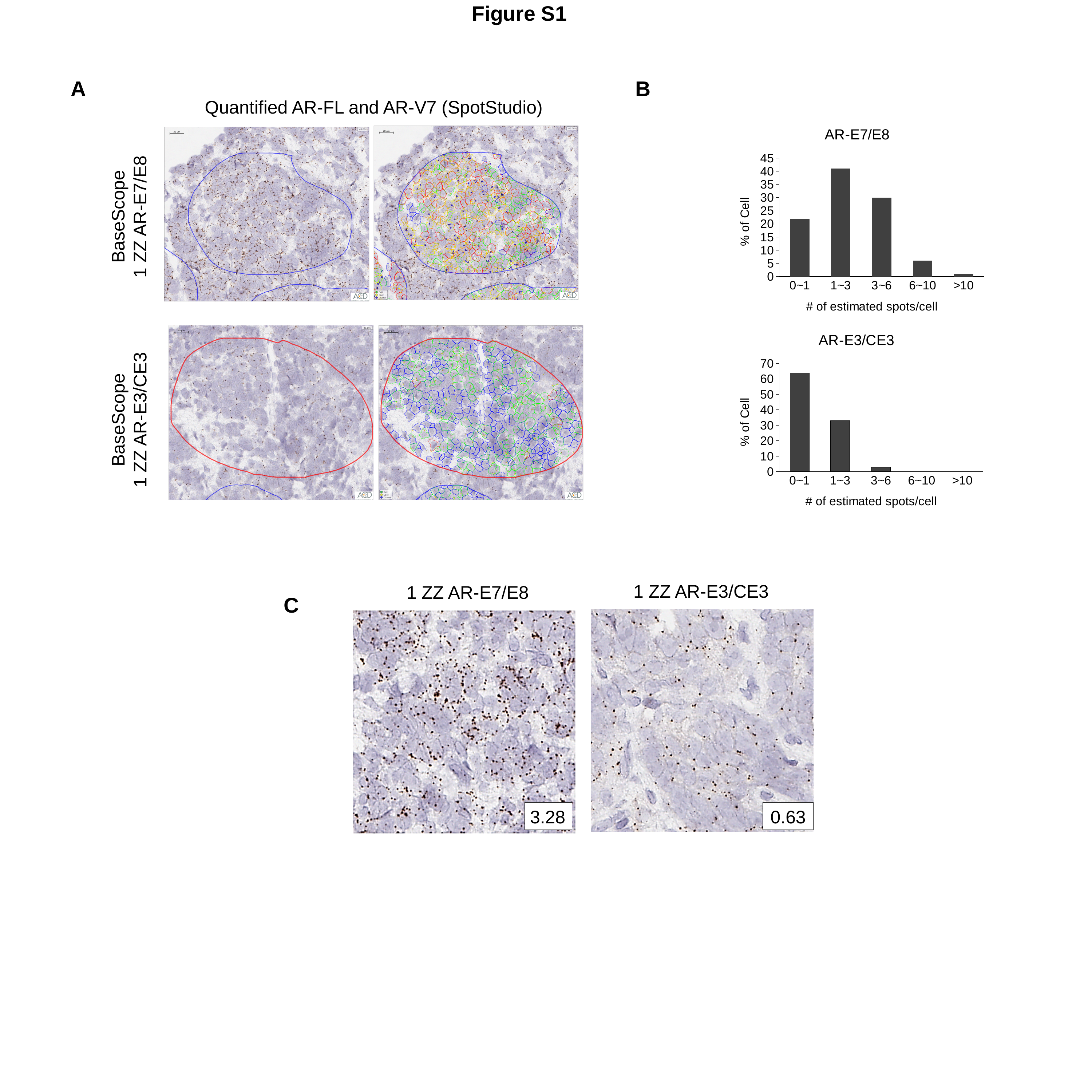
In the AR-E3/CE3 chart, is the % of Cell for 1~3 spots/cell greater or less than 40? less In the AR-E3/CE3 chart, is the % of Cell for 0~1 spots/cell greater or less than 60? greater In the AR-E7/E8 chart, which category of estimated spots/cell has the highest % of Cell? 1~3 What kind of chart is the AR-E7/E8 chart? bar chart In the AR-E3/CE3 chart, which has a higher % of Cell: 0~1 or 1~3 spots/cell? 0~1 In the AR-E7/E8 chart, which has a higher % of Cell: 3~6 or 6~10 spots/cell? 3~6 In the AR-E7/E8 chart, which category of estimated spots/cell has the lowest % of Cell? >10 In the AR-E3/CE3 chart, do the % of Cell values rise or fall from 0~1 to 3~6 spots/cell? fall In the AR-E7/E8 chart, is the % of Cell for 0~1 spots/cell greater or less than 25? less How many categories of estimated spots/cell are shown on the x axis of the AR-E3/CE3 chart? 5 In the AR-E3/CE3 chart, which category of estimated spots/cell has the highest % of Cell? 0~1